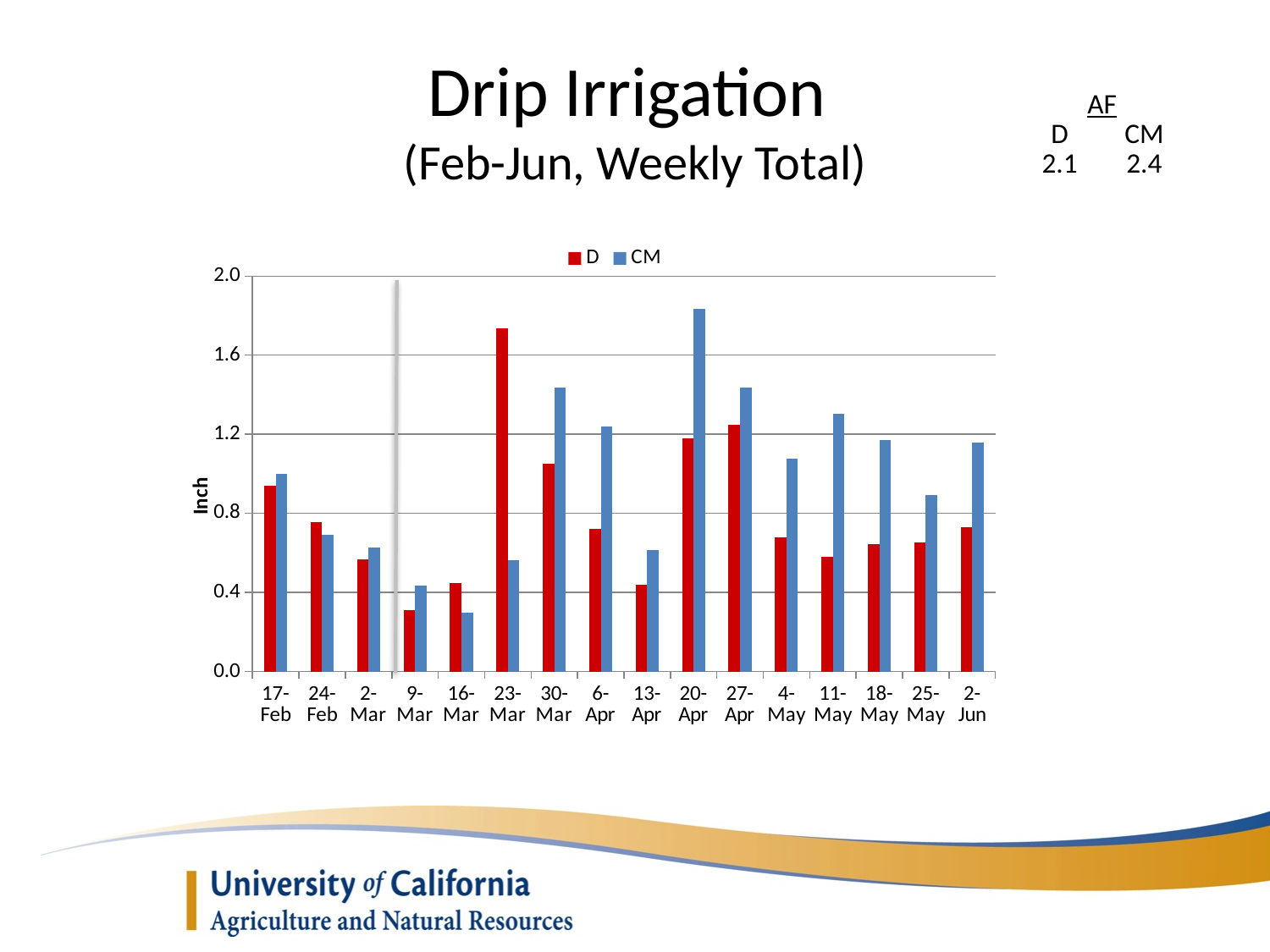
What is the label on the vertical axis? Inch What is the title of the chart? Drip Irrigation (Feb-Jun, Weekly Total) In which week is the D value highest? 23-Mar In which week is the CM value highest? 20-Apr How many series does the legend list? 2 Is the D value for 23-Mar greater or less than 1.6? greater In which week is the CM value lowest? 16-Mar How many weekly categories are shown on the x axis? 16 What kind of chart is shown on the slide? bar chart In which week is the D value lowest? 9-Mar For 11-May, which series has the larger value, D or CM? CM Is the CM value for 16-Mar greater or less than 0.4? less